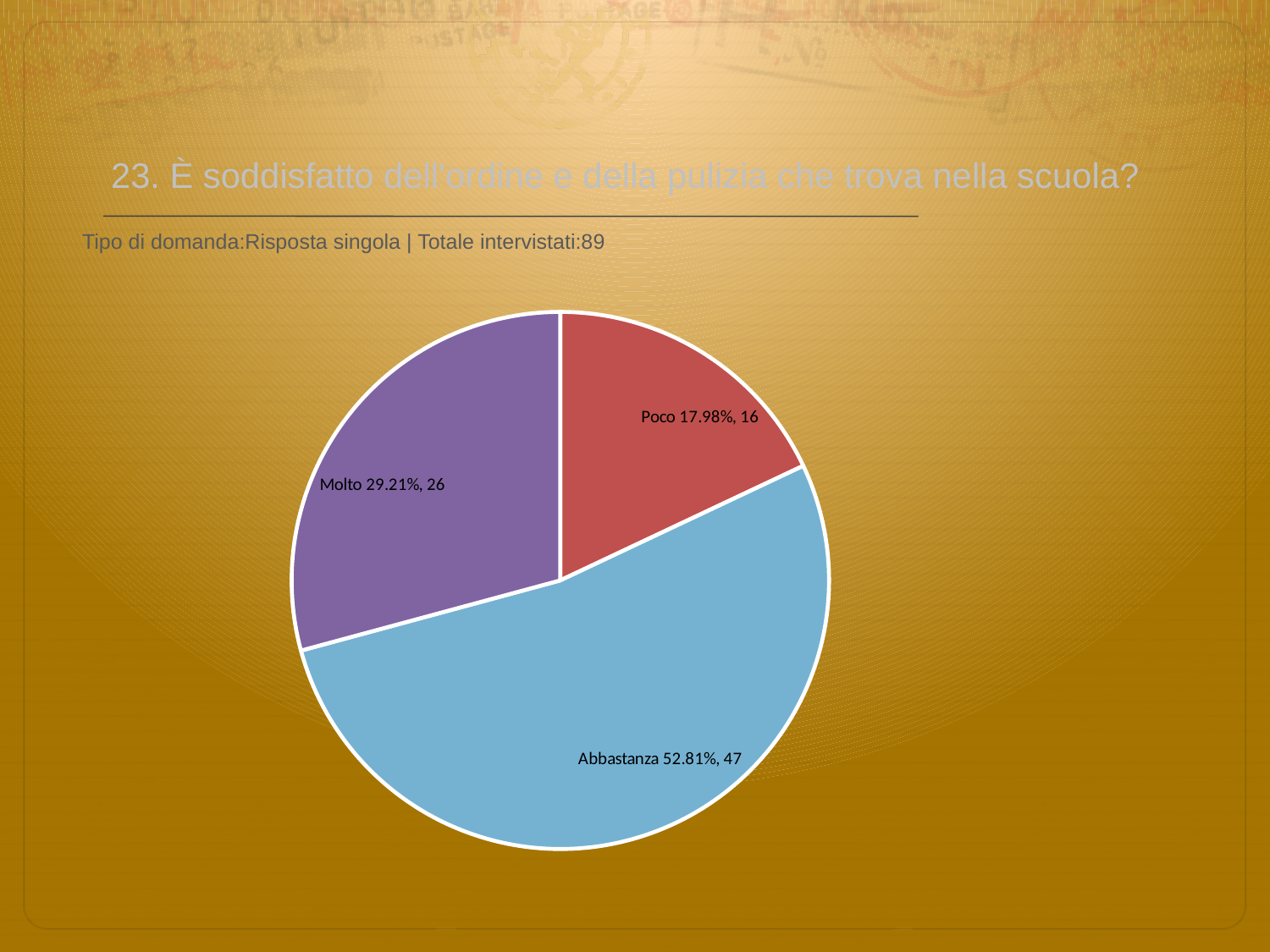
Which category has the largest slice? Abbastanza What is the total number of respondents across all slices? 89 Which has more respondents, Molto or Poco? Molto What is the difference in respondent count between Abbastanza and Molto? 21 How many respondents answered Poco? 16 How many respondents answered Molto? 26 What colour is the Abbastanza slice? light blue What percentage share does the Poco slice have? 17.98% Which category has the smallest slice? Poco How many slices does the pie chart have? 3 What kind of chart is shown on the slide? pie chart What percentage share does the Abbastanza slice have? 52.81%